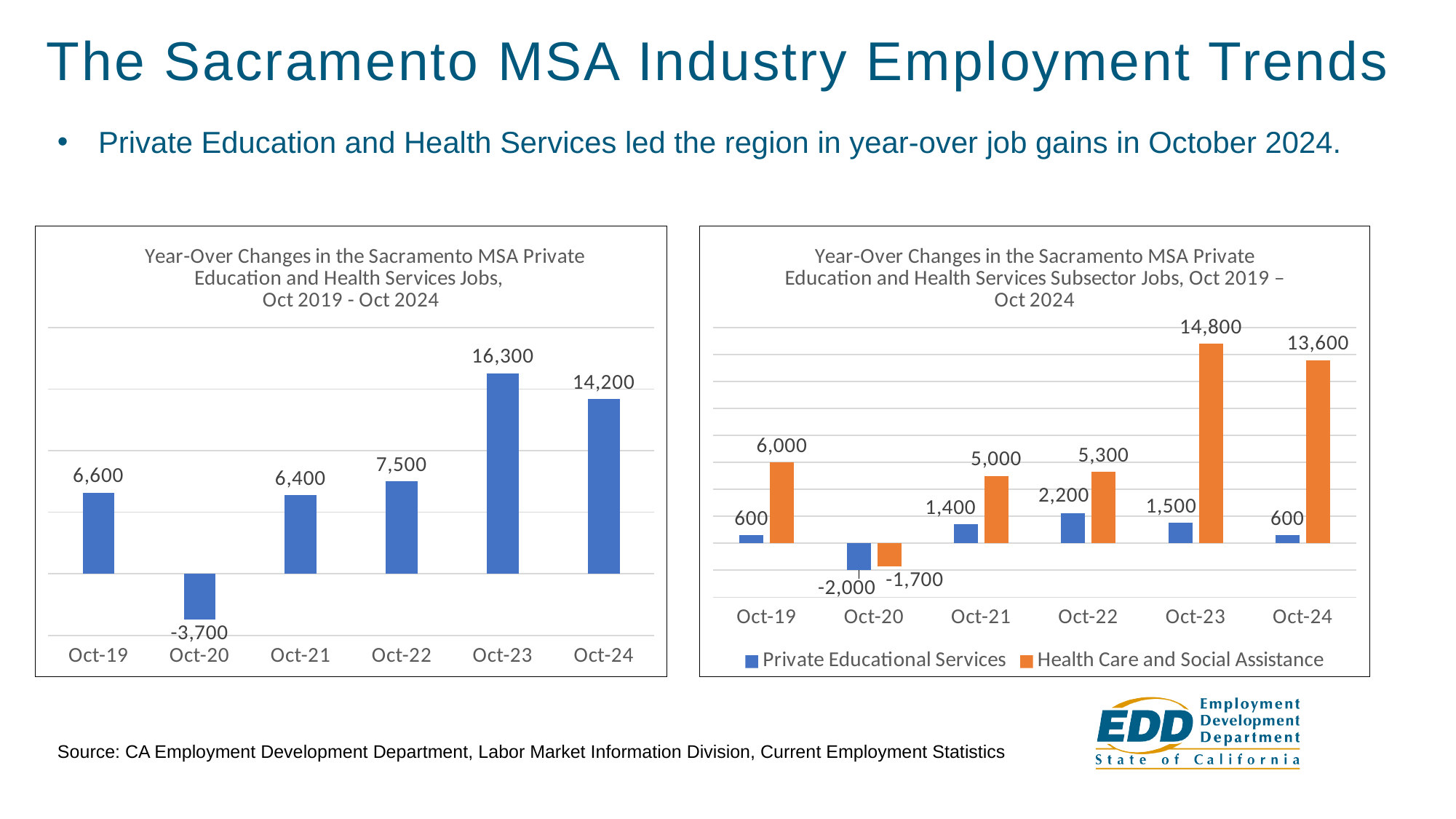
In the left chart (Year-Over Changes in the Sacramento MSA Private Education and Health Services Jobs), what is the difference between the Oct-23 and Oct-24 values? 2,100 In the left chart (Year-Over Changes in the Sacramento MSA Private Education and Health Services Jobs), which year has the lowest value? Oct-20 In the right chart (Subsector Jobs), how many series does the legend list? 2 In the right chart (Subsector Jobs), which is larger in Oct-21: Private Educational Services or Health Care and Social Assistance? Health Care and Social Assistance In the left chart (Year-Over Changes in the Sacramento MSA Private Education and Health Services Jobs), which year has the highest value? Oct-23 In the left chart (Year-Over Changes in the Sacramento MSA Private Education and Health Services Jobs), what is the value for Oct-20? -3,700 In the right chart (Subsector Jobs), what is the value for Private Educational Services in Oct-22? 2,200 In the right chart (Subsector Jobs), what is the value for Health Care and Social Assistance in Oct-23? 14,800 What type of chart is the left chart (Year-Over Changes in the Sacramento MSA Private Education and Health Services Jobs)? Bar chart In the left chart (Year-Over Changes in the Sacramento MSA Private Education and Health Services Jobs), how many years are shown on the x axis? 6 In the left chart (Year-Over Changes in the Sacramento MSA Private Education and Health Services Jobs), what is the value for Oct-23? 16,300 In the right chart (Subsector Jobs), what is the difference between the Health Care and Social Assistance values for Oct-23 and Oct-24? 1,200